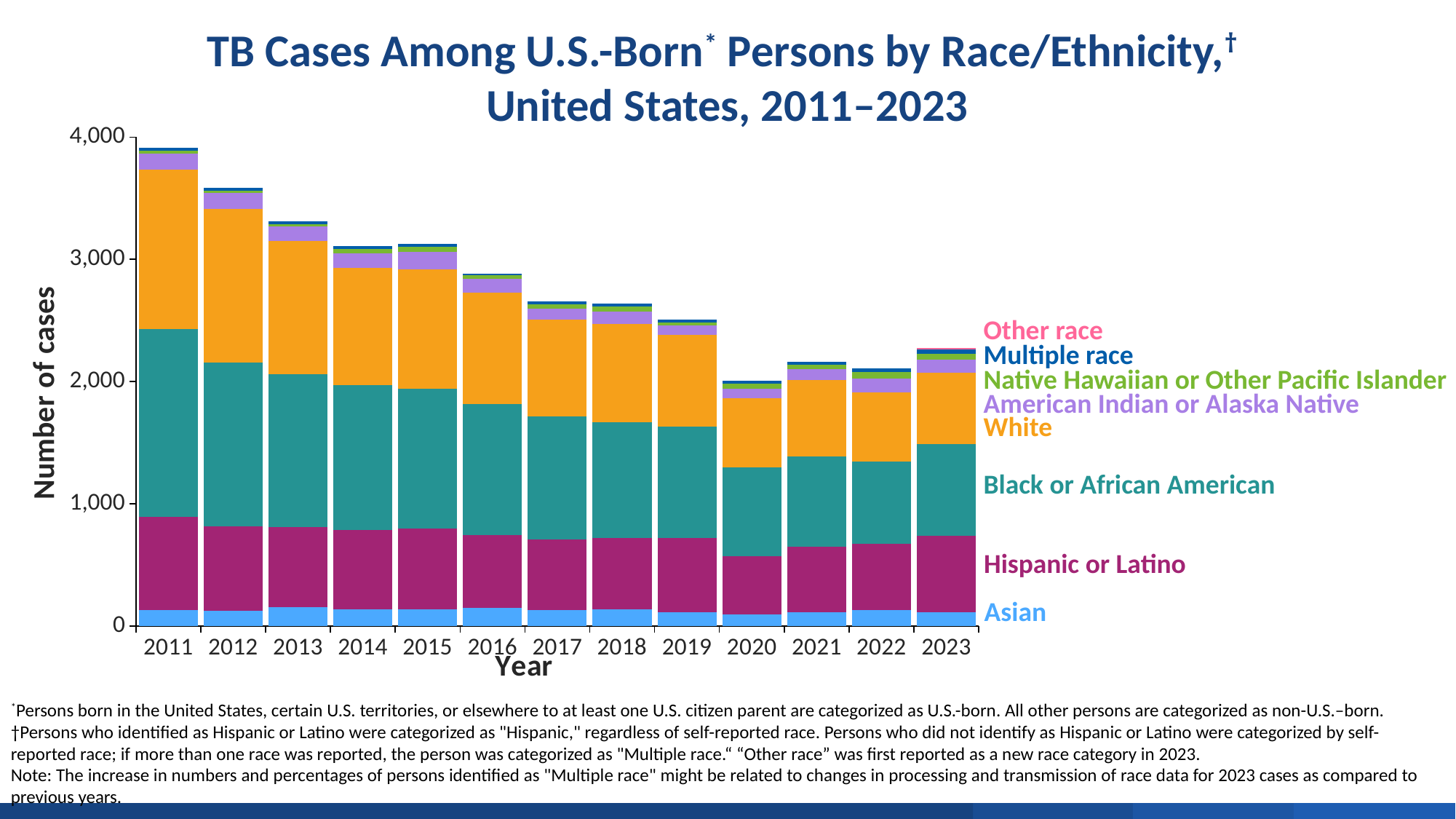
Which year has the highest total number of TB cases among U.S.-born persons? 2011 Is the total number of cases in 2019 greater or less than 3,000? less How many race/ethnicity categories does the legend list? 8 Is the total number of cases in 2020 greater or less than 2,500? less What colour represents the White category in the chart? Orange Which race/ethnicity category forms the bottom segment of each stacked bar? Asian Is the total number of cases in 2011 greater or less than 3,000? greater Which year has a larger total number of cases, 2011 or 2023? 2011 Which year has the lowest total number of TB cases among U.S.-born persons? 2020 How many years (bars) are shown on the x axis? 13 What kind of chart is shown on the slide? Stacked bar chart How does the total number of TB cases change from 2011 to 2020? It falls